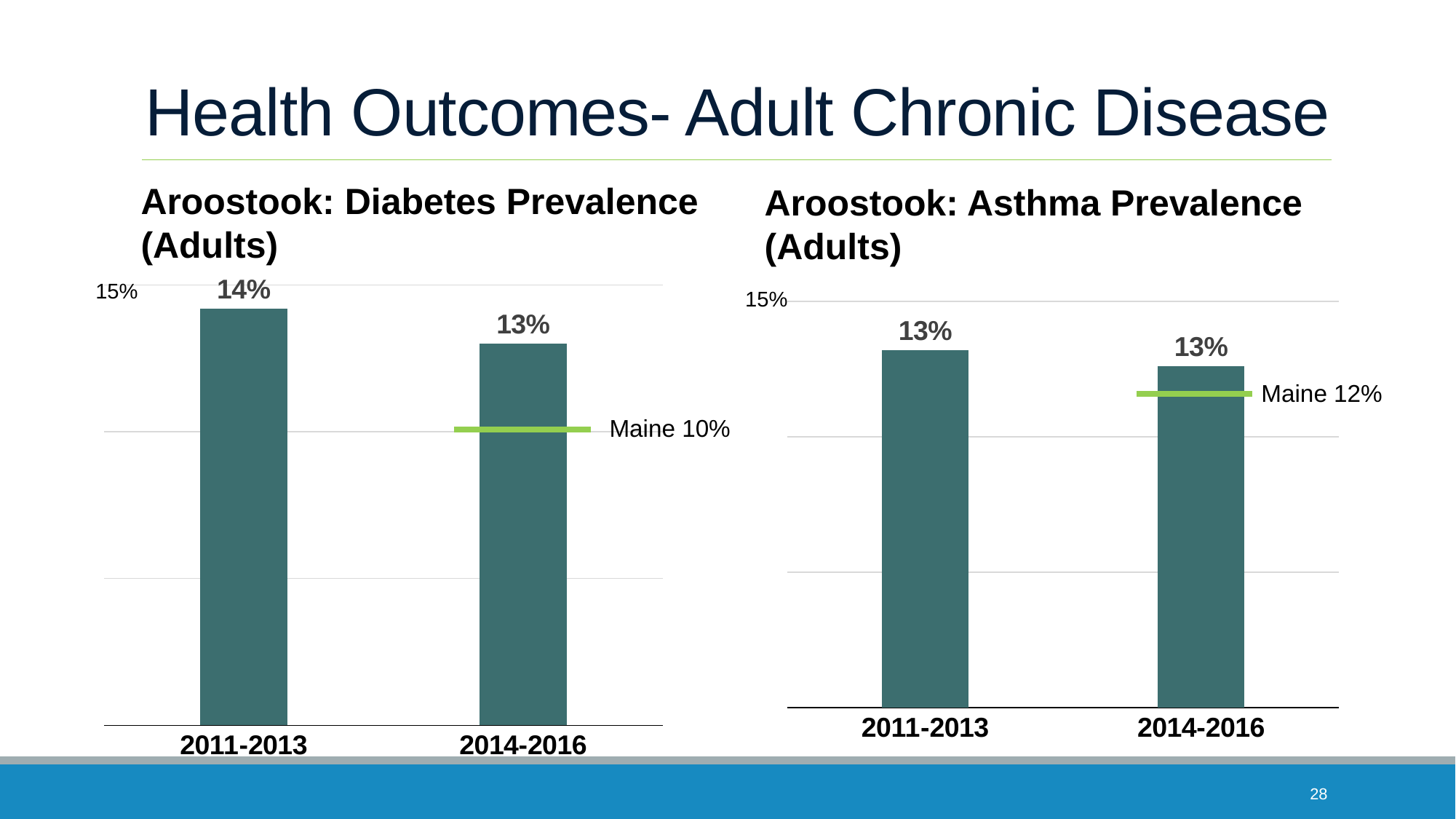
In the Aroostook: Diabetes Prevalence (Adults) chart, do the values rise or fall from 2011-2013 to 2014-2016? fall In the Aroostook: Diabetes Prevalence (Adults) chart, what is the value for 2014-2016? 13% In the Aroostook: Diabetes Prevalence (Adults) chart, which is larger: the Aroostook 2014-2016 value or the Maine reference value? Aroostook 2014-2016 In the Aroostook: Asthma Prevalence (Adults) chart, what is the value for 2011-2013? 13% In the Aroostook: Diabetes Prevalence (Adults) chart, what Maine value is marked by the reference line? 10% In the Aroostook: Asthma Prevalence (Adults) chart, what Maine value is marked by the reference line? 12% In the Aroostook: Diabetes Prevalence (Adults) chart, which period has the higher value? 2011-2013 In the Aroostook: Asthma Prevalence (Adults) chart, what is the value for 2014-2016? 13% In the Aroostook: Diabetes Prevalence (Adults) chart, what is the difference between the 2011-2013 and 2014-2016 values? 1% What kind of chart is the Aroostook: Diabetes Prevalence (Adults) chart? bar chart How many time periods are shown in the Aroostook: Asthma Prevalence (Adults) chart? 2 In the Aroostook: Diabetes Prevalence (Adults) chart, what is the value for 2011-2013? 14%